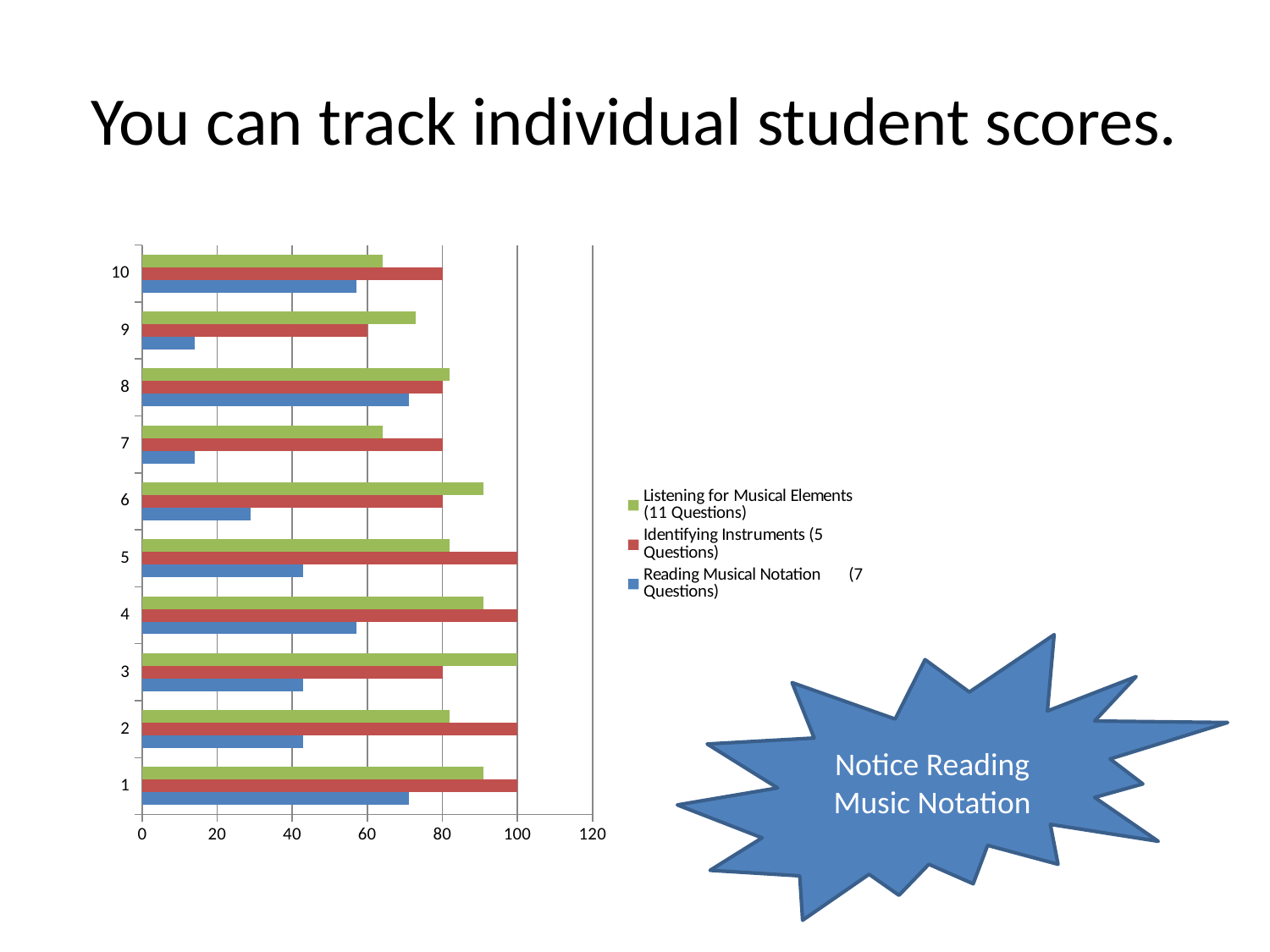
What kind of chart is shown on the slide? bar chart Is the Reading Musical Notation (7 Questions) value for student 9 greater or less than 20? less Which is larger, the Reading Musical Notation (7 Questions) score for student 1 or for student 9? student 1 How many series does the legend list? 3 How many student categories are shown on the vertical axis? 10 Is the Reading Musical Notation (7 Questions) value for student 1 greater or less than 60? greater Which colour represents Reading Musical Notation (7 Questions) in the chart? blue What is the Listening for Musical Elements (11 Questions) score for student 3? 100 What is the Identifying Instruments (5 Questions) score for student 1? 100 What is the Identifying Instruments (5 Questions) score for student 10? 80 Which is larger, the Listening for Musical Elements (11 Questions) score for student 3 or for student 10? student 3 Is the Listening for Musical Elements (11 Questions) value for student 6 greater or less than 80? greater